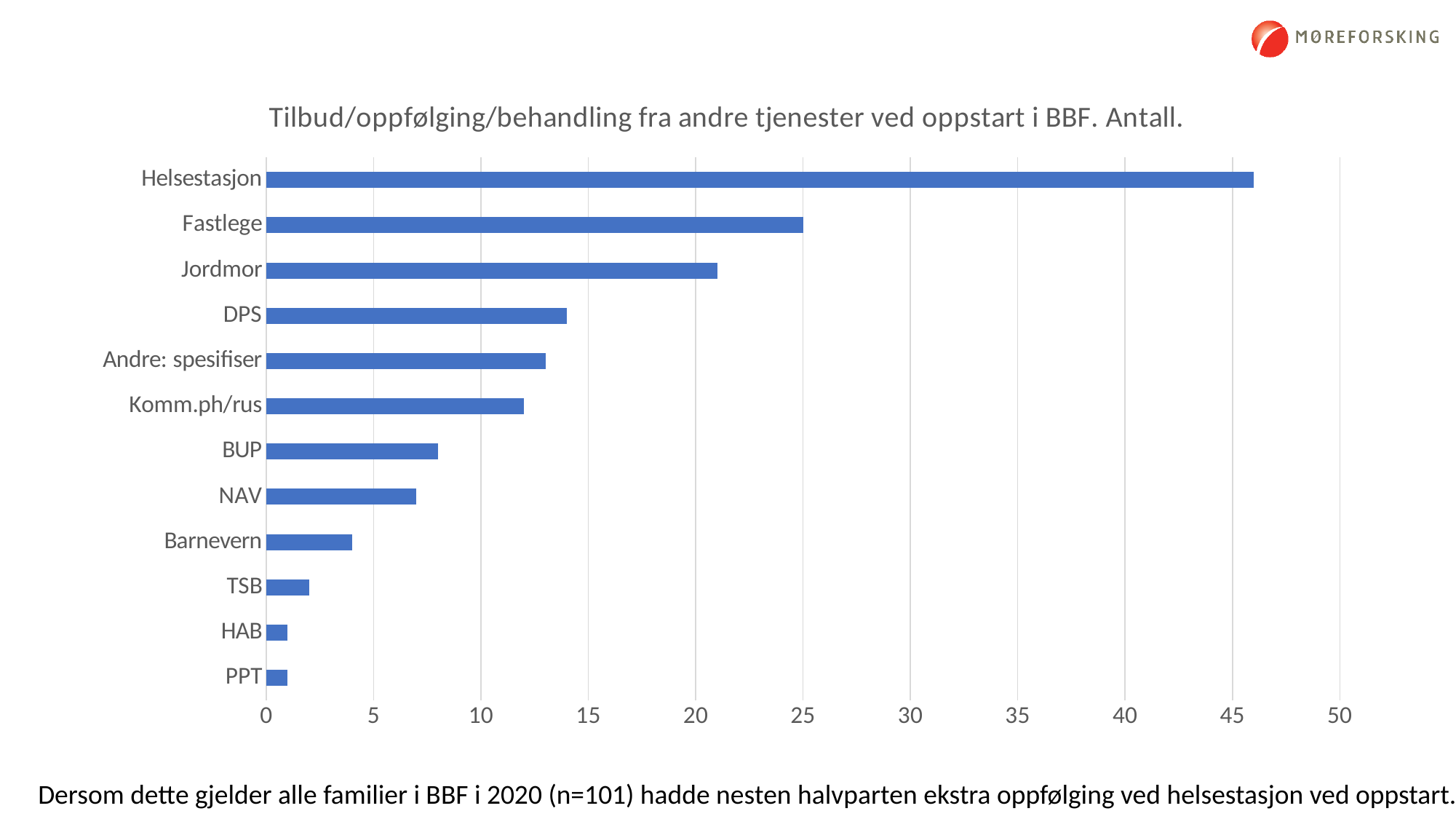
Which category has the highest value? Helsestasjon Is the value for Helsestasjon greater or less than 45? greater Which has a larger value, Jordmor or DPS? Jordmor How many categories are shown in the chart? 12 Which has a larger value, NAV or Komm.ph/rus? Komm.ph/rus What kind of chart is shown on the slide? bar chart What is the title of the chart? Tilbud/oppfølging/behandling fra andre tjenester ved oppstart i BBF. Antall. Is the value for BUP greater or less than 10? less What is the value for Fastlege? 25 Is the value for Jordmor greater or less than 20? greater